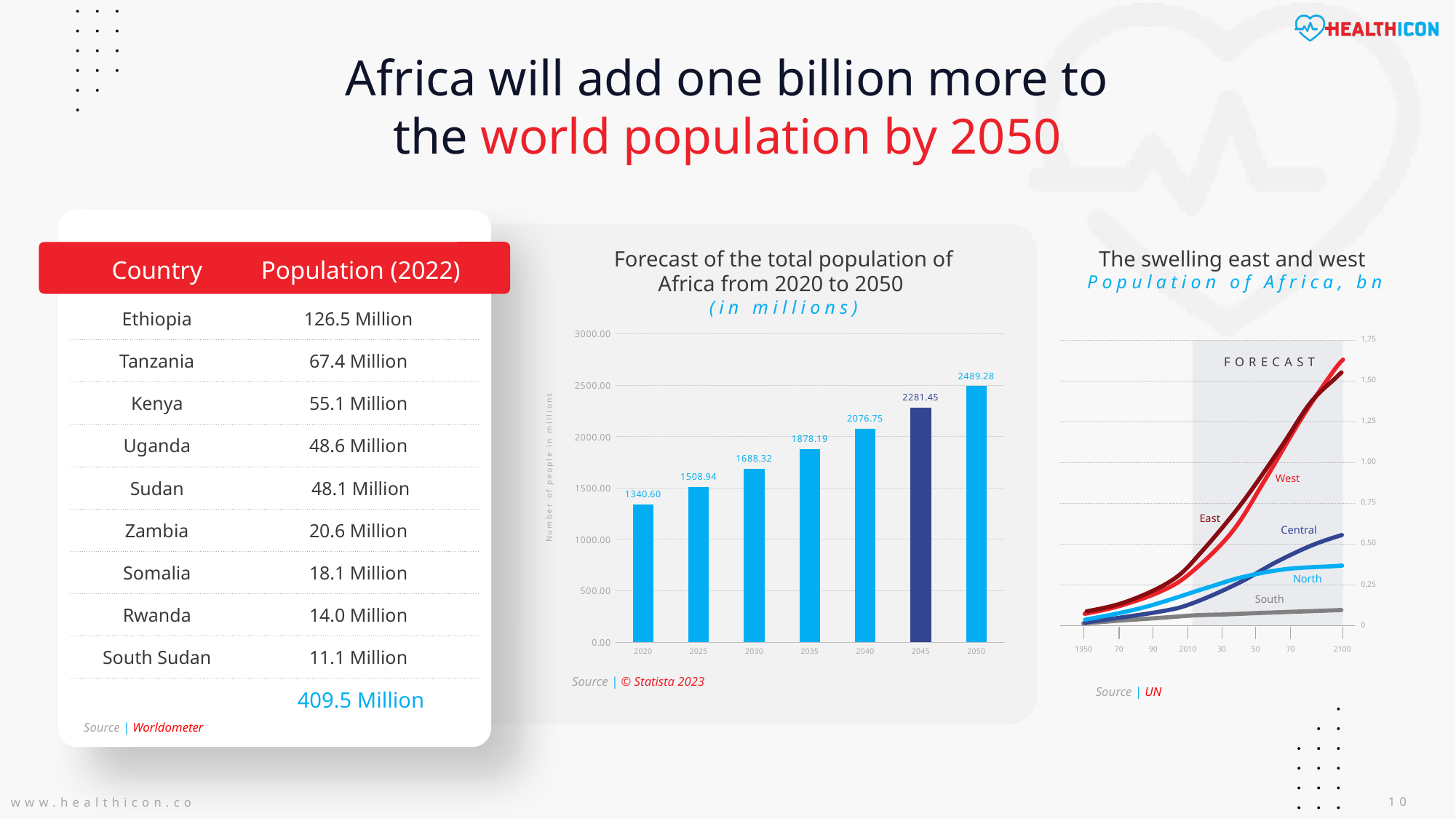
In the bar chart 'Forecast of the total population of Africa from 2020 to 2050', how many bars are plotted? 7 In the bar chart 'Forecast of the total population of Africa from 2020 to 2050', which year has the lowest value? 2020 What kind of chart is 'The swelling east and west'? line chart What kind of chart is 'Forecast of the total population of Africa from 2020 to 2050'? bar chart In the bar chart 'Forecast of the total population of Africa from 2020 to 2050', what is the difference between the values for 2045 and 2040? 204.70 In the chart 'The swelling east and west', how many regions are plotted as lines? 5 In the bar chart 'Forecast of the total population of Africa from 2020 to 2050', what is the value for 2045? 2281.45 In the bar chart 'Forecast of the total population of Africa from 2020 to 2050', what is the value for 2020? 1340.60 In the bar chart 'Forecast of the total population of Africa from 2020 to 2050', do the values rise or fall from 2020 to 2050? rise In the chart 'The swelling east and west', is the value for South at 2100 greater or less than 0.25? less In the bar chart 'Forecast of the total population of Africa from 2020 to 2050', which year has the highest value? 2050 In the bar chart 'Forecast of the total population of Africa from 2020 to 2050', what is the difference between the values for 2050 and 2020? 1148.68